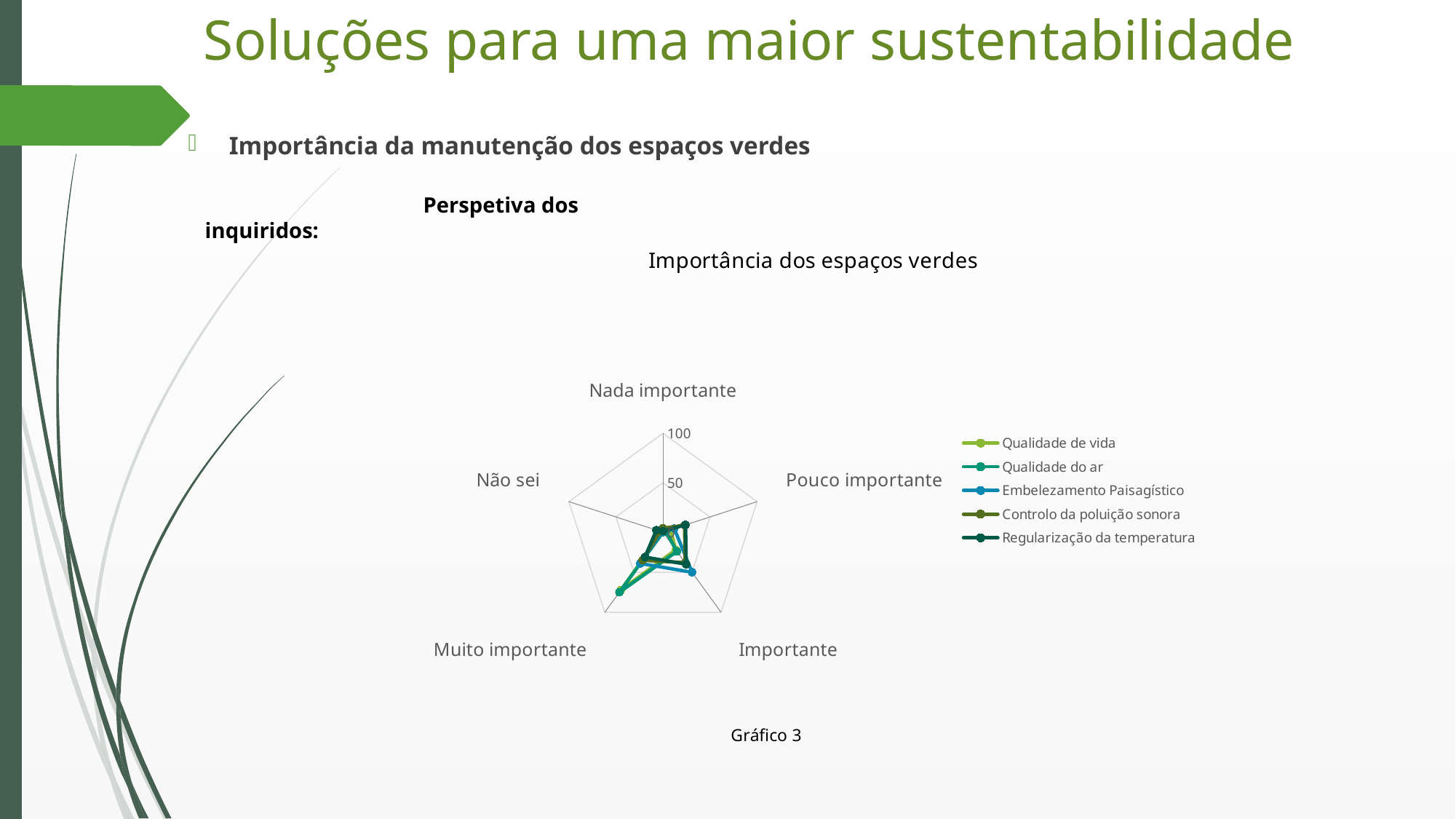
For the series Qualidade do ar, is the value at Muito importante larger or smaller than the value at Nada importante? larger What kind of chart is shown on the slide? radar chart Is the value for Qualidade do ar at Muito importante greater or less than 50? greater Is the value for Controlo da poluição sonora at Não sei greater or less than 50? less How many categories (axes) does the radar chart have? 5 How many series does the legend list? 5 What is the title of the chart? Importância dos espaços verdes For the series Qualidade do ar, which category has the highest value? Muito importante What is the caption shown below the chart? Gráfico 3 Is the value for Embelezamento Paisagístico at Pouco importante greater or less than 50? less Which series is listed first in the legend? Qualidade de vida